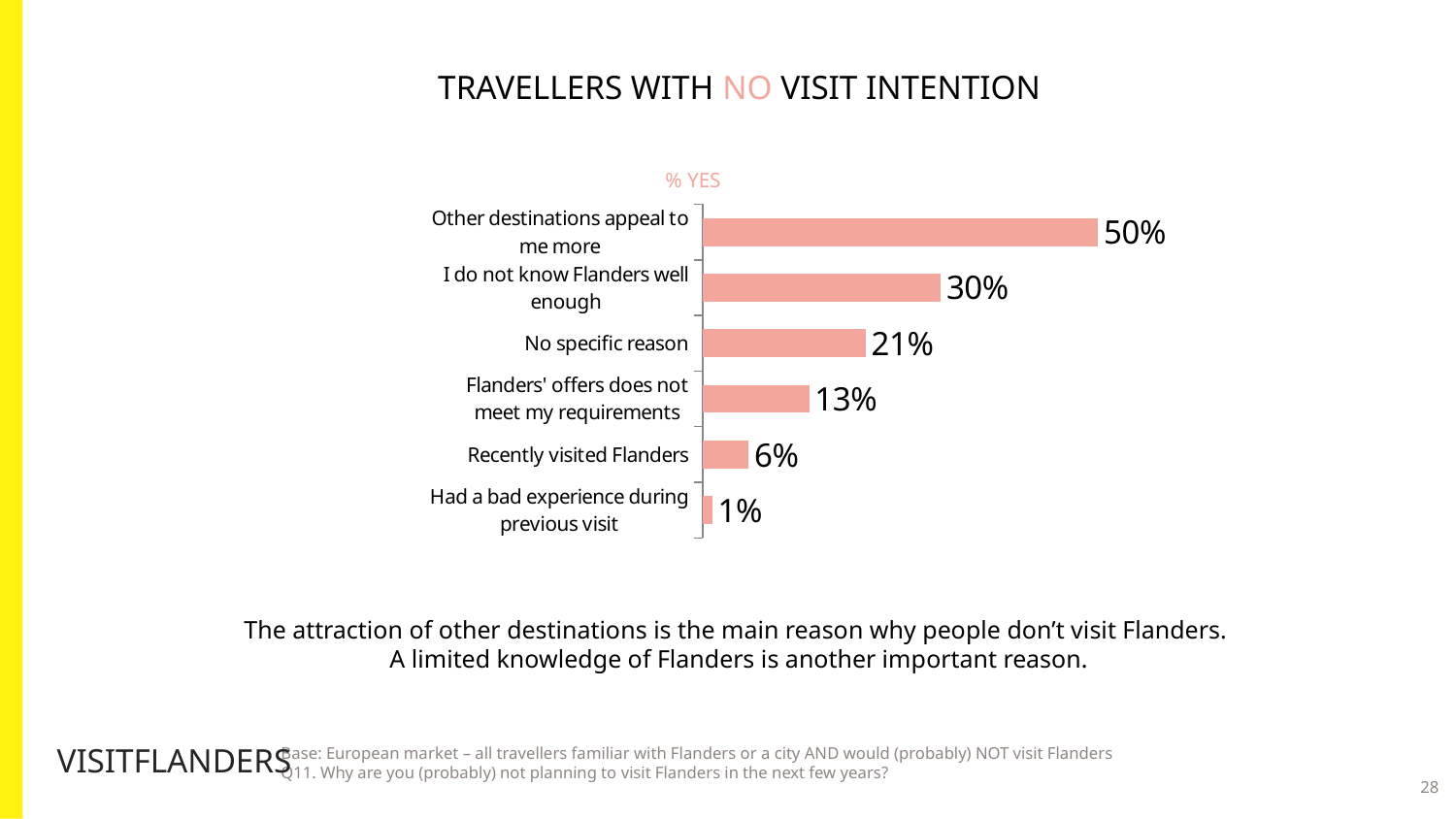
What is the value for 'Flanders' offers does not meet my requirements'? 13% What type of chart is shown on the slide? Bar chart Which reason has the lowest percentage? Had a bad experience during previous visit How many reasons are shown in the chart? 6 What is the value for 'I do not know Flanders well enough'? 30% What is the value for 'No specific reason'? 21% Which reason has the highest percentage? Other destinations appeal to me more What percentage of travellers with no visit intention said 'Other destinations appeal to me more'? 50% Which is larger: 'Recently visited Flanders' or 'No specific reason'? No specific reason What is the difference between 'Other destinations appeal to me more' and 'I do not know Flanders well enough'? 20% What is the label shown above the chart indicating what the values represent? % YES What is the value for 'Had a bad experience during previous visit'? 1%